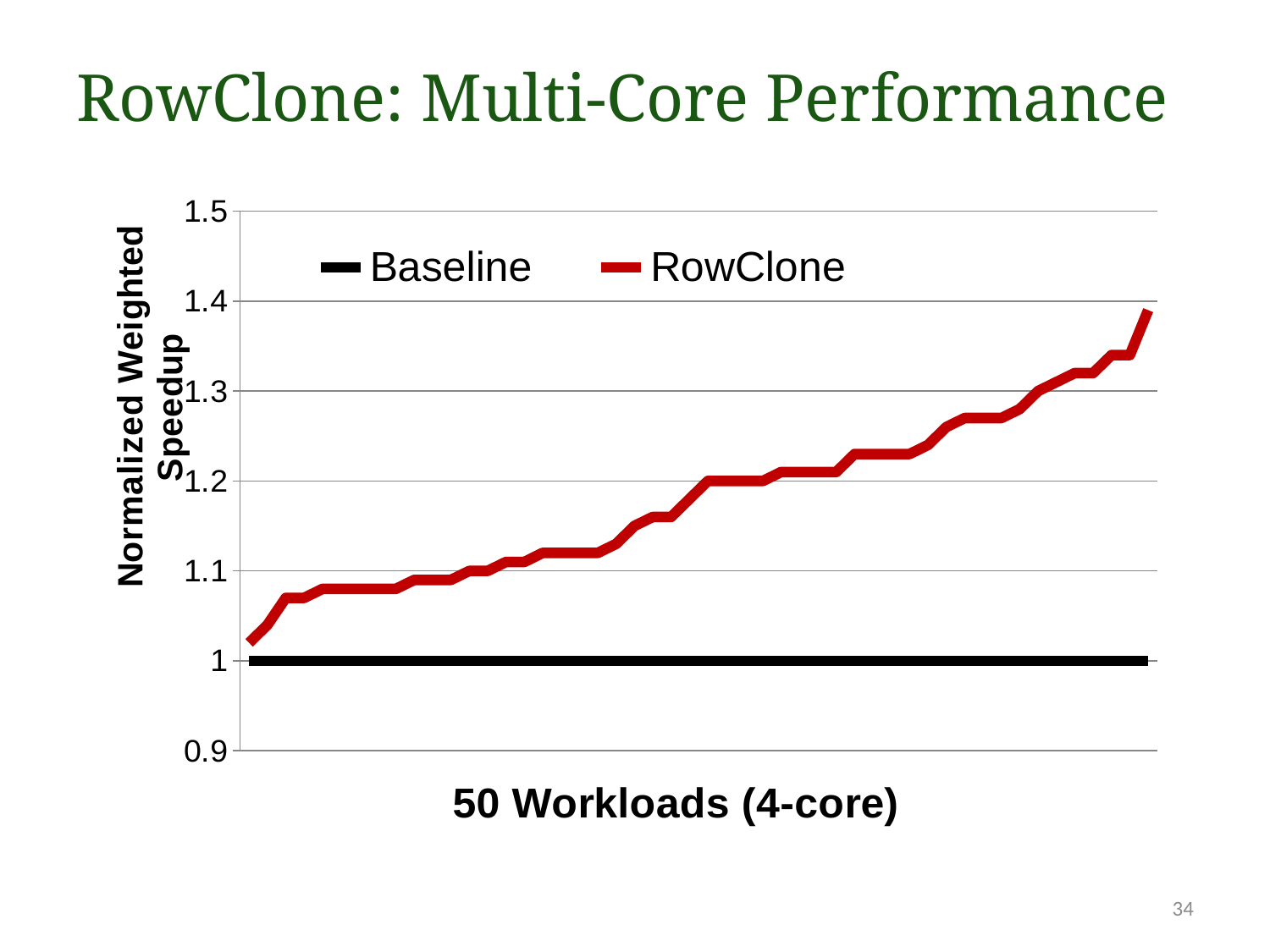
Which series is drawn in red? RowClone How many workloads does the x-axis label say are plotted? 50 What are the two series named in the legend? Baseline and RowClone How many series does the legend list? 2 What kind of chart is shown on the slide? line chart Does the RowClone series rise or fall along the x axis? rise What is the title of the slide's chart? RowClone: Multi-Core Performance What is the value of the Baseline series across the workloads? 1 Which series has the larger value for the last workload, Baseline or RowClone? RowClone Is the highest RowClone value greater or less than 1.3? greater Is the lowest RowClone value greater or less than 1.1? less